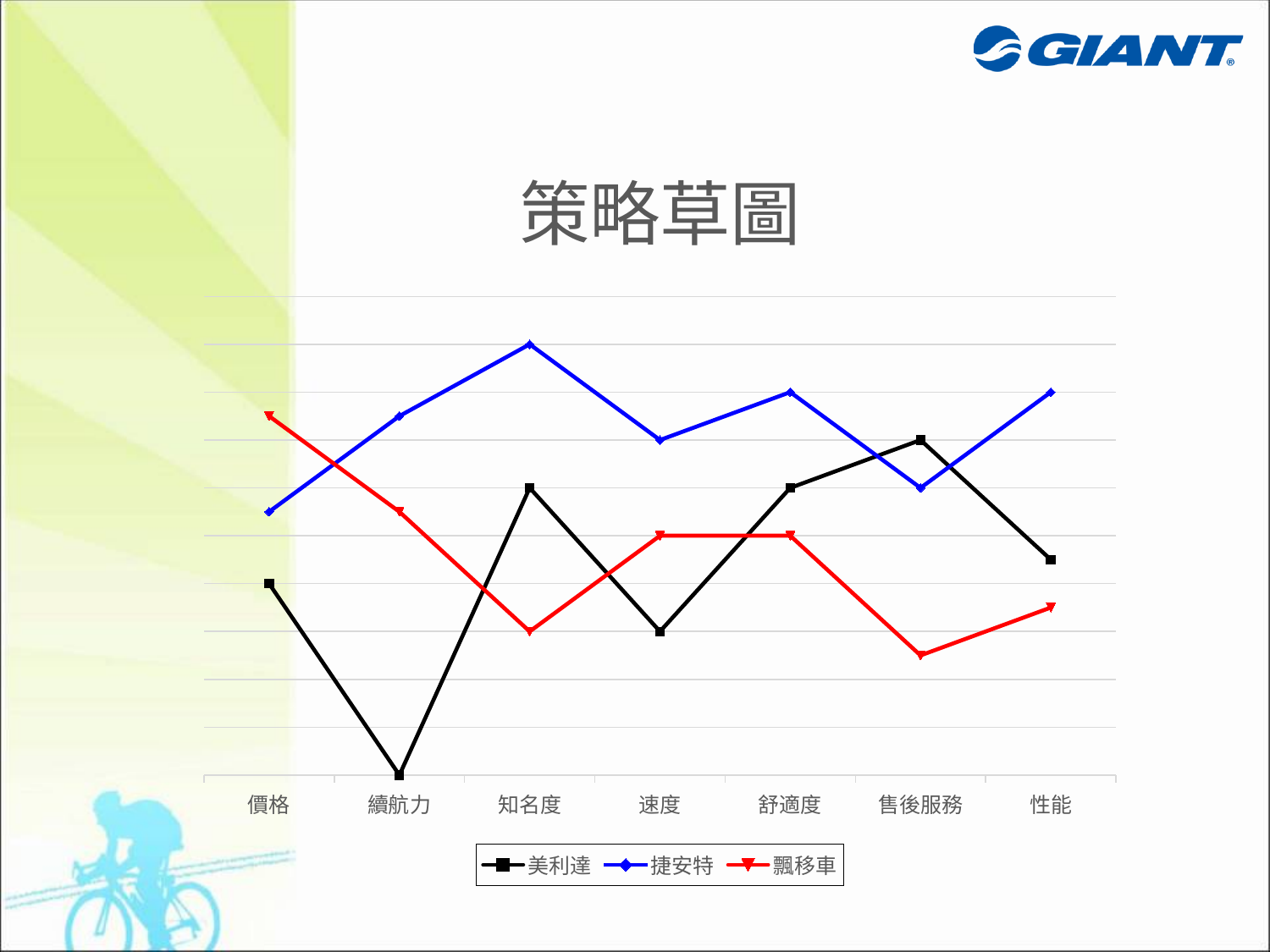
At 售後服務, which series is higher: 美利達 or 捷安特? 美利達 What kind of chart is shown on the slide? line chart For which category does the 美利達 line reach its lowest point? 續航力 For which category does the 飄移車 line reach its lowest point? 售後服務 For which category does the 飄移車 line reach its highest point? 價格 For which category does the 美利達 line reach its highest point? 售後服務 What is the title of the chart? 策略草圖 How many categories are shown along the x axis of the chart? 7 How many series does the chart's legend list? 3 Does the 捷安特 line rise or fall from 售後服務 to 性能? rise At 價格, which series is higher: 飄移車 or 美利達? 飄移車 For which category does the 捷安特 line reach its highest point? 知名度